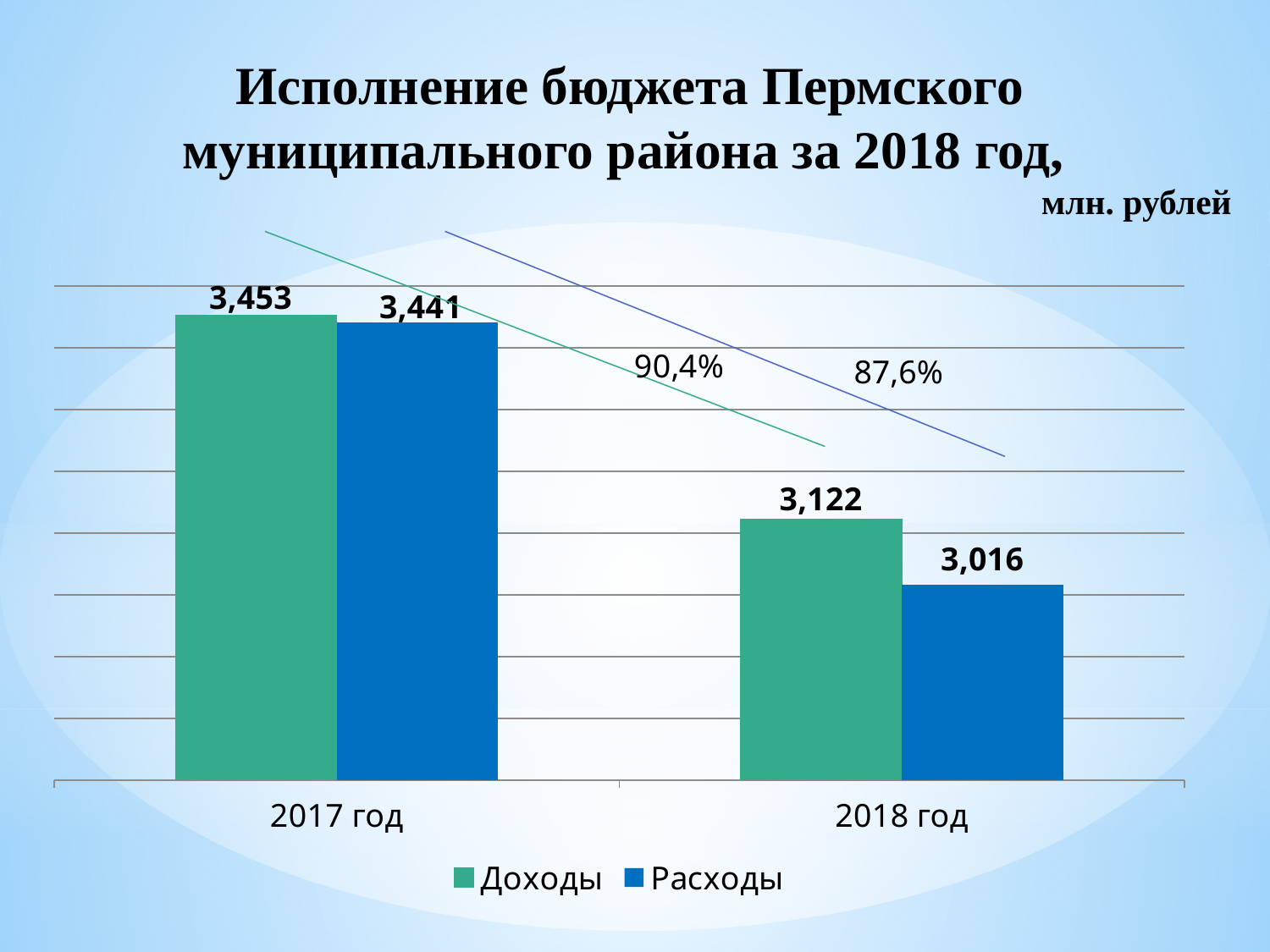
What is the difference between Доходы and Расходы for 2018 год? 106 Which bar has the highest value on the chart? Доходы, 2017 год What kind of chart is shown on the slide? Bar chart What is the value of Расходы for 2018 год? 3,016 What is the value of Расходы for 2017 год? 3,441 By how much did Доходы decrease from 2017 год to 2018 год? 331 Which bar has the lowest value on the chart? Расходы, 2018 год How many series does the legend list? 2 Do the Расходы values rise or fall from 2017 год to 2018 год? Fall What is the value of Доходы for 2017 год? 3,453 Which is larger for 2018 год, Доходы or Расходы? Доходы What is the value of Доходы for 2018 год? 3,122